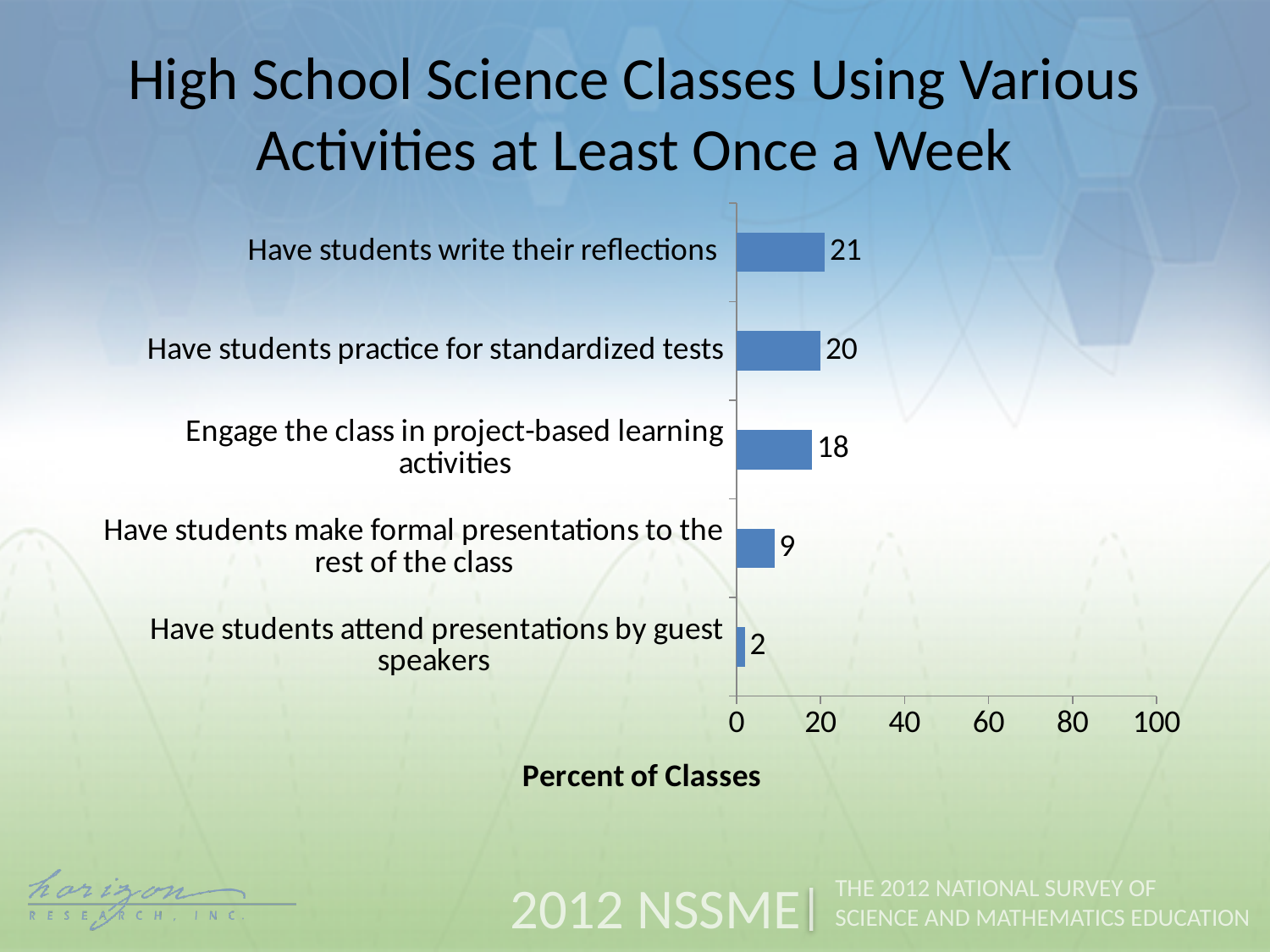
What kind of chart is shown on the slide? bar chart How many activities are shown in the chart? 5 What percent of classes have students write their reflections at least once a week? 21 What is the value for 'Engage the class in project-based learning activities'? 18 Which activity has the highest percent of classes? Have students write their reflections Which activity has the lowest percent of classes? Have students attend presentations by guest speakers Is the value for 'Have students write their reflections' greater or less than 40? less What is the difference between the values for 'Have students practice for standardized tests' and 'Have students make formal presentations to the rest of the class'? 11 Which is larger: the value for 'Engage the class in project-based learning activities' or the value for 'Have students make formal presentations to the rest of the class'? Engage the class in project-based learning activities What is the highest tick value shown on the horizontal axis? 100 What is the value for 'Have students attend presentations by guest speakers'? 2 What is the label of the horizontal axis? Percent of Classes